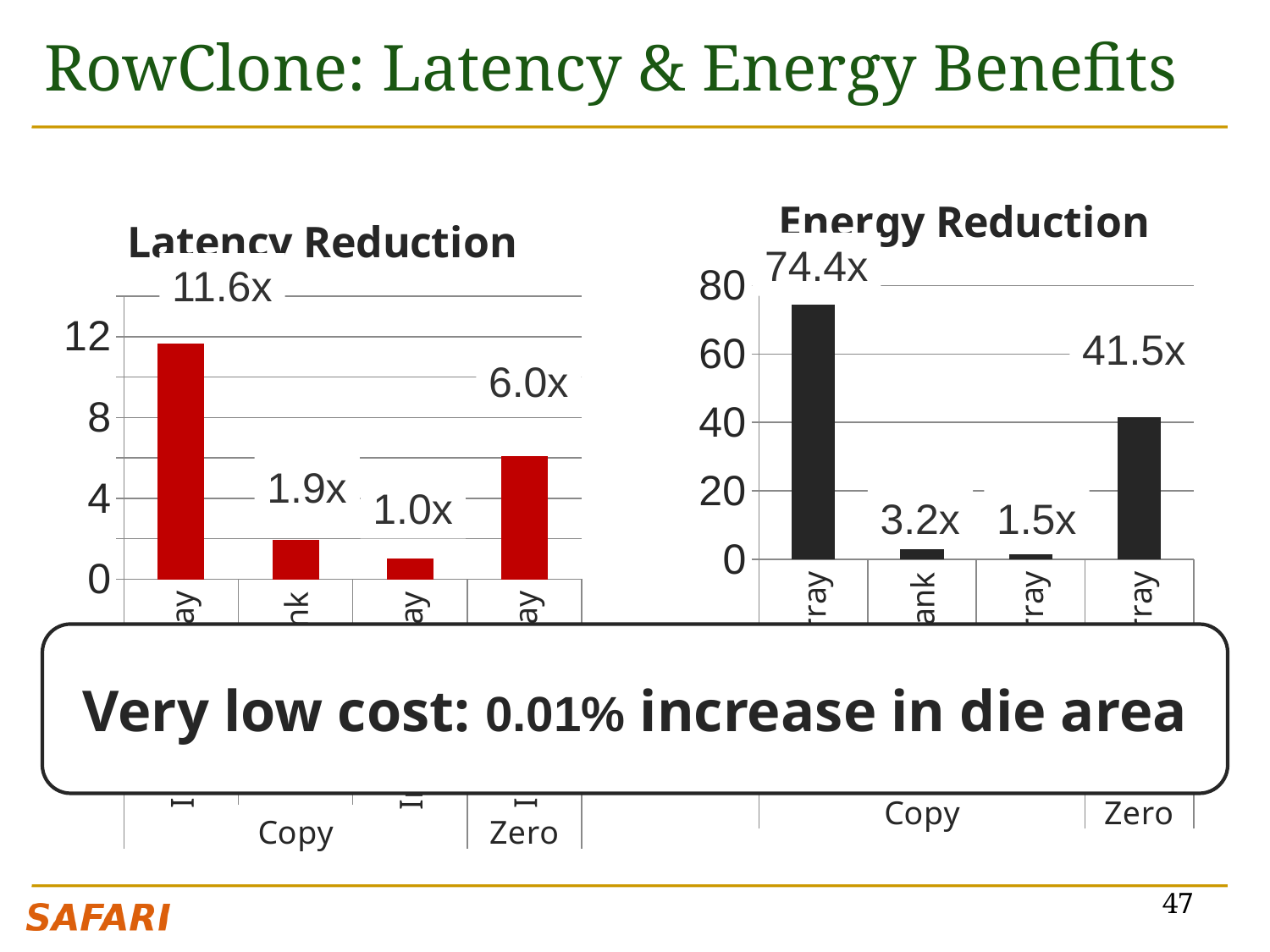
In the Latency Reduction chart, which is larger: the second bar (1.9x) or the third bar (1.0x)? the second bar (1.9x) In the Energy Reduction chart, what is the difference between the highest value (74.4x) and the Zero bar (41.5x)? 32.9x In the Energy Reduction chart, is the value of the leftmost bar greater or less than 60? greater In the Latency Reduction chart, what is the lowest value shown? 1.0x In the Latency Reduction chart, what is the value of the bar in the Zero group? 6.0x In the Energy Reduction chart, what is the lowest value shown? 1.5x In the Latency Reduction chart, what is the highest value shown? 11.6x In the Energy Reduction chart, what is the value of the first (leftmost) bar? 74.4x In the Latency Reduction chart, what is the value of the first (leftmost) bar? 11.6x How many bars are plotted in the Energy Reduction chart? 4 What kind of chart is the Latency Reduction chart? bar chart In the Energy Reduction chart, what is the value of the bar in the Zero group? 41.5x